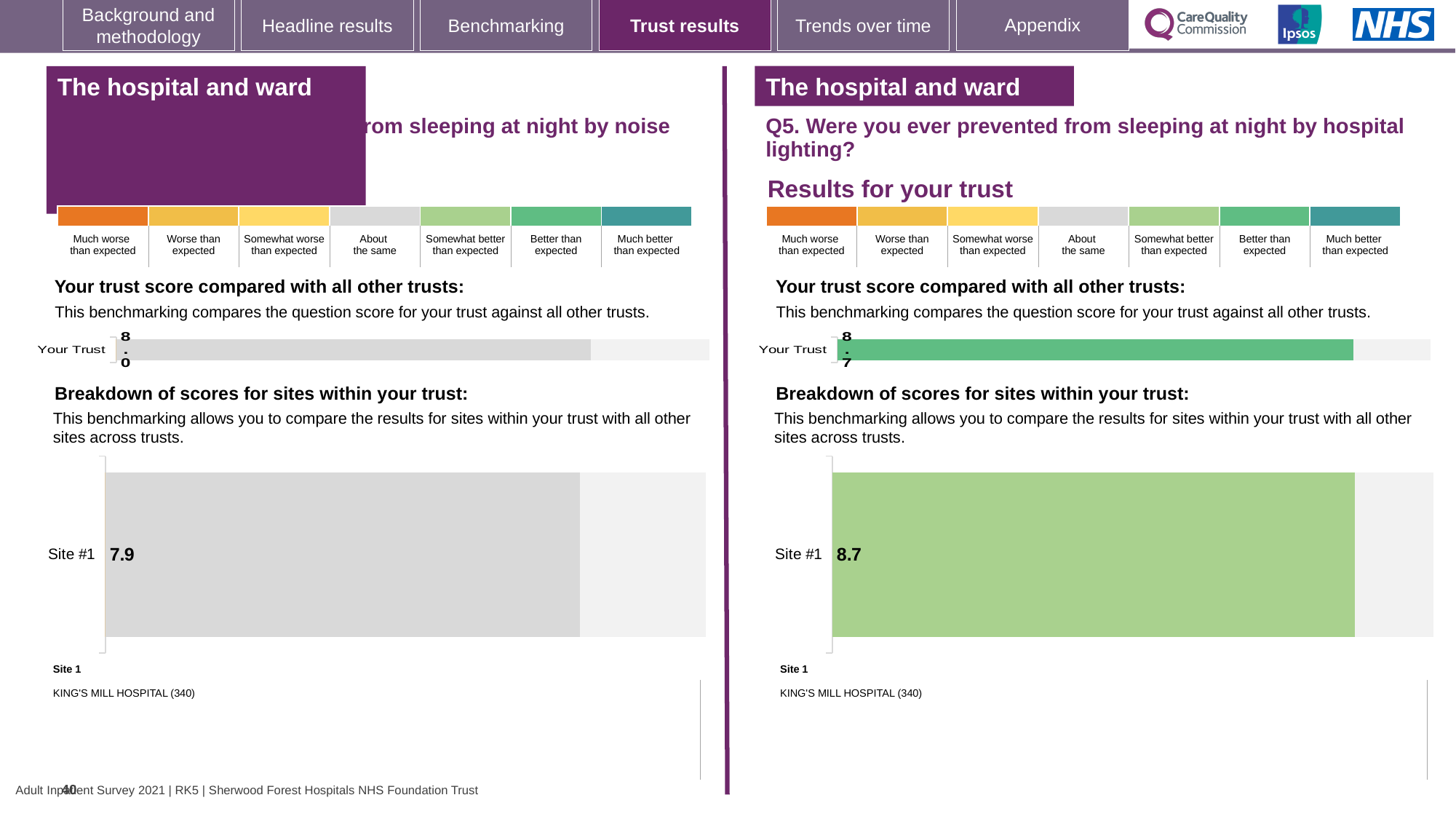
Which hospital is listed as Site 1 on the right half of the slide? KING'S MILL HOSPITAL (340) How many sites are shown in the breakdown of scores for sites within your trust on the left half of the slide? 1 On the right half of the slide (Q5, hospital lighting), is the Site #1 score greater or less than the Your Trust score, or are they equal? Equal On the left half of the slide, what is the score shown for Your Trust in the trust score comparison chart? 8.0 On the left half of the slide, what is the score shown for Site #1 in the breakdown of scores for sites within your trust? 7.9 What is the difference between the Site #1 score on the right half of the slide (8.7) and the Site #1 score on the left half (7.9)? 0.8 What is the difference between the Your Trust score on the right half of the slide (8.7) and the Your Trust score on the left half (8.0)? 0.7 On the right half of the slide (Q5, hospital lighting), what is the score shown for Your Trust in the trust score comparison chart? 8.7 Which Site #1 score is larger: the one on the left half of the slide or the one on the right half (Q5, hospital lighting)? The right half (Q5, hospital lighting) How many benchmark categories are shown in the colour key above the trust score comparison on the right half of the slide? 7 On the right half of the slide (Q5, hospital lighting), what is the score shown for Site #1 in the breakdown of scores for sites within your trust? 8.7 What type of chart is used to show the Site #1 score in the breakdown of scores for sites within your trust on the right half of the slide? Bar chart